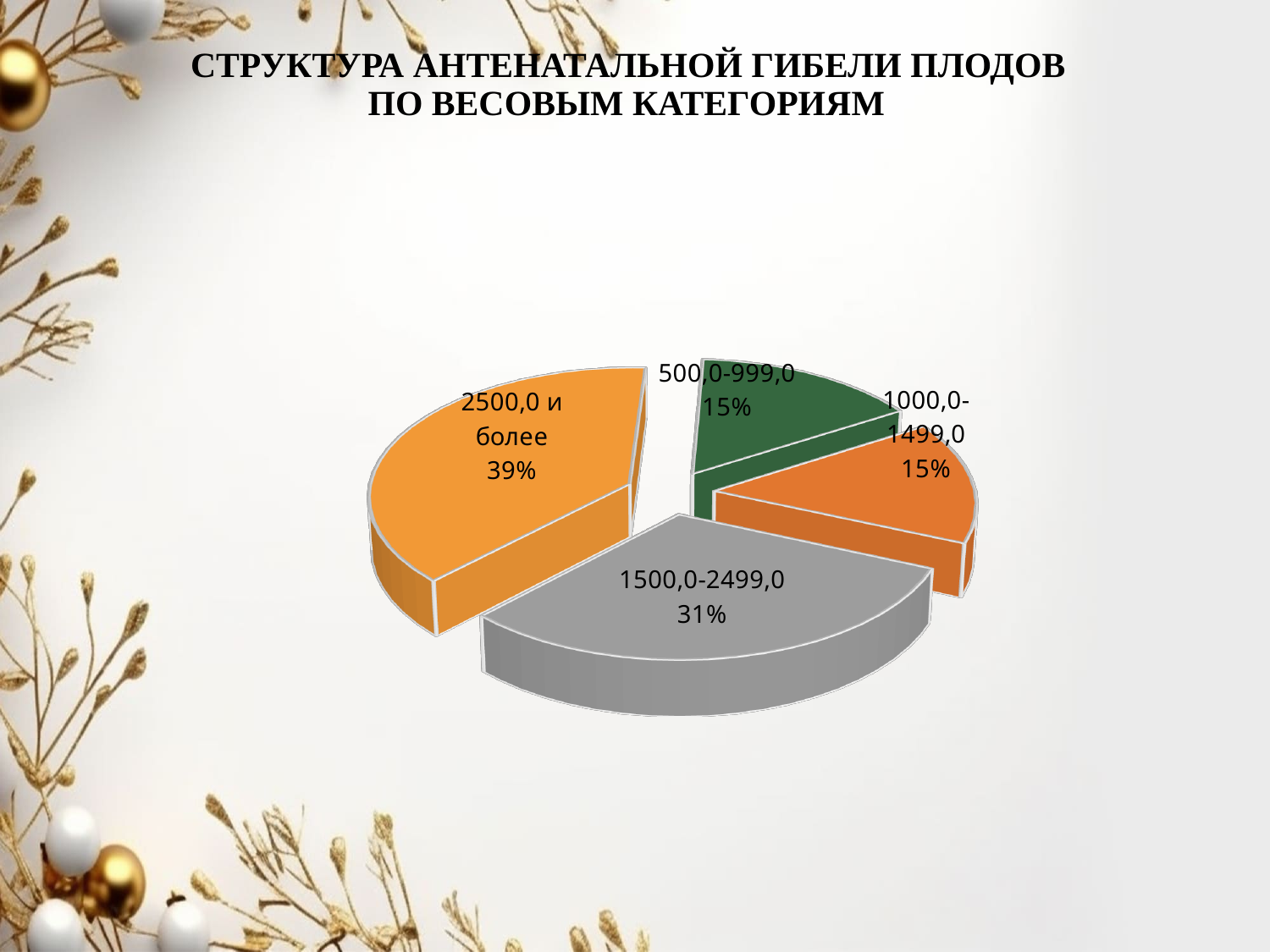
Which is larger: the share for '1500,0-2499,0' or the share for '500,0-999,0'? 1500,0-2499,0 What is the difference in percentage points between the '2500,0 и более' slice and the '1500,0-2499,0' slice? 8 percentage points What share of the pie does the '2500,0 и более' category have? 39% How many categories (slices) does the pie chart show? 4 What share of the pie does the '1500,0-2499,0' category have? 31% What is the combined share of the '500,0-999,0' and '1000,0-1499,0' slices? 30% Which weight category has the largest share of the pie? 2500,0 и более What colour is the slice for the '1500,0-2499,0' category? Grey What kind of chart is shown on the slide? Pie chart What is the title of the chart on the slide? СТРУКТУРА АНТЕНАТАЛЬНОЙ ГИБЕЛИ ПЛОДОВ ПО ВЕСОВЫМ КАТЕГОРИЯМ What share of the pie does the '1000,0-1499,0' category have? 15%